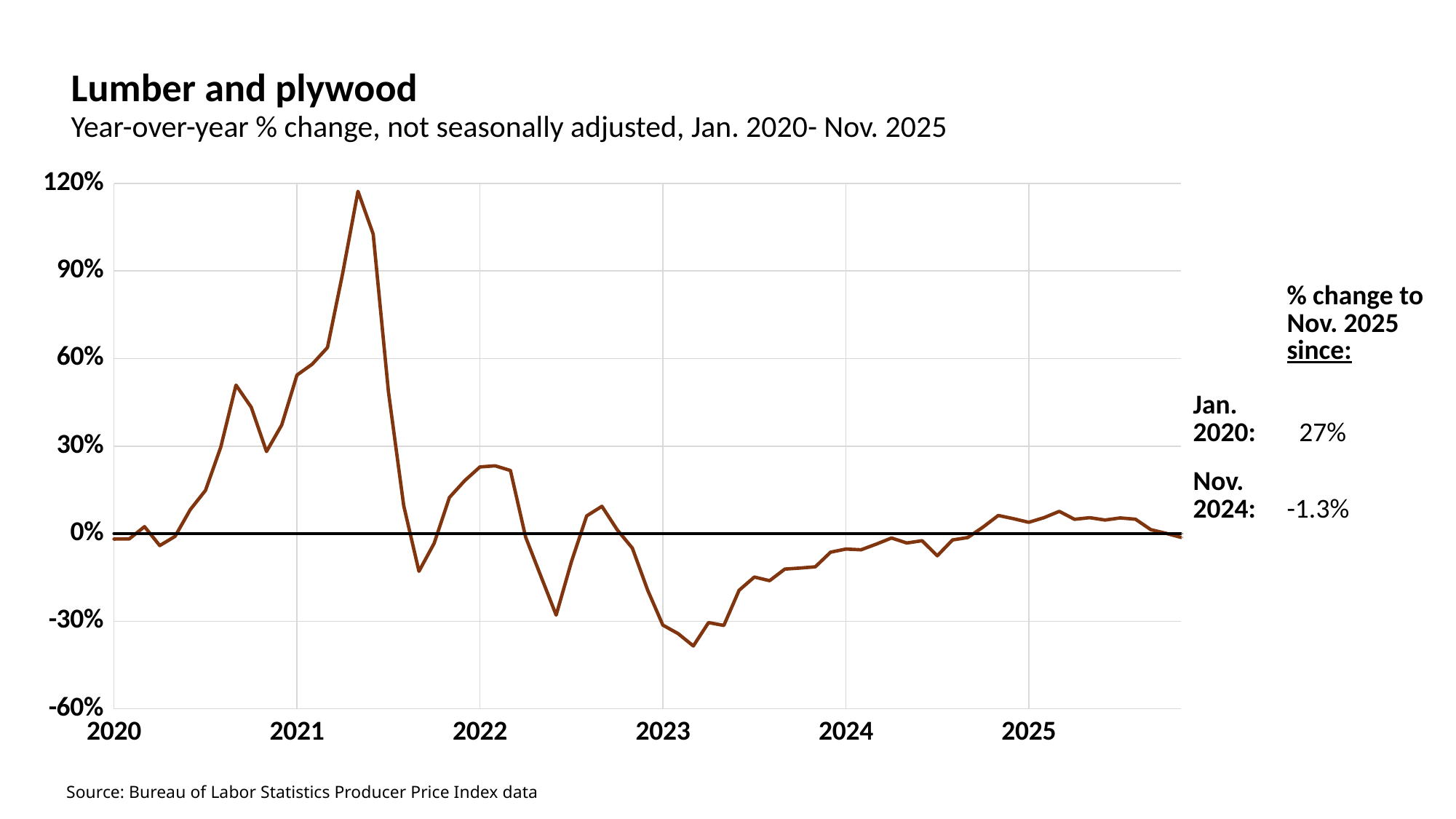
What is the title of the chart? Lumber and plywood In which year does the line reach its highest value? 2021 Does the line rise or fall between its 2021 peak and the end of 2021? fall Is the value at the start of 2021 greater or less than 30%? greater What kind of chart is shown on the slide? line chart According to the annotation, what is the % change to Nov. 2025 since Jan. 2020? 27% Is the lowest value of the line in 2023 greater or less than -30%? less In which year does the line reach its lowest value? 2023 Is the peak value of the line in 2021 greater or less than 90%? greater Which is larger: the value at the start of 2021 or the value at the start of 2023? the value at the start of 2021 According to the annotation, what is the % change to Nov. 2025 since Nov. 2024? -1.3%